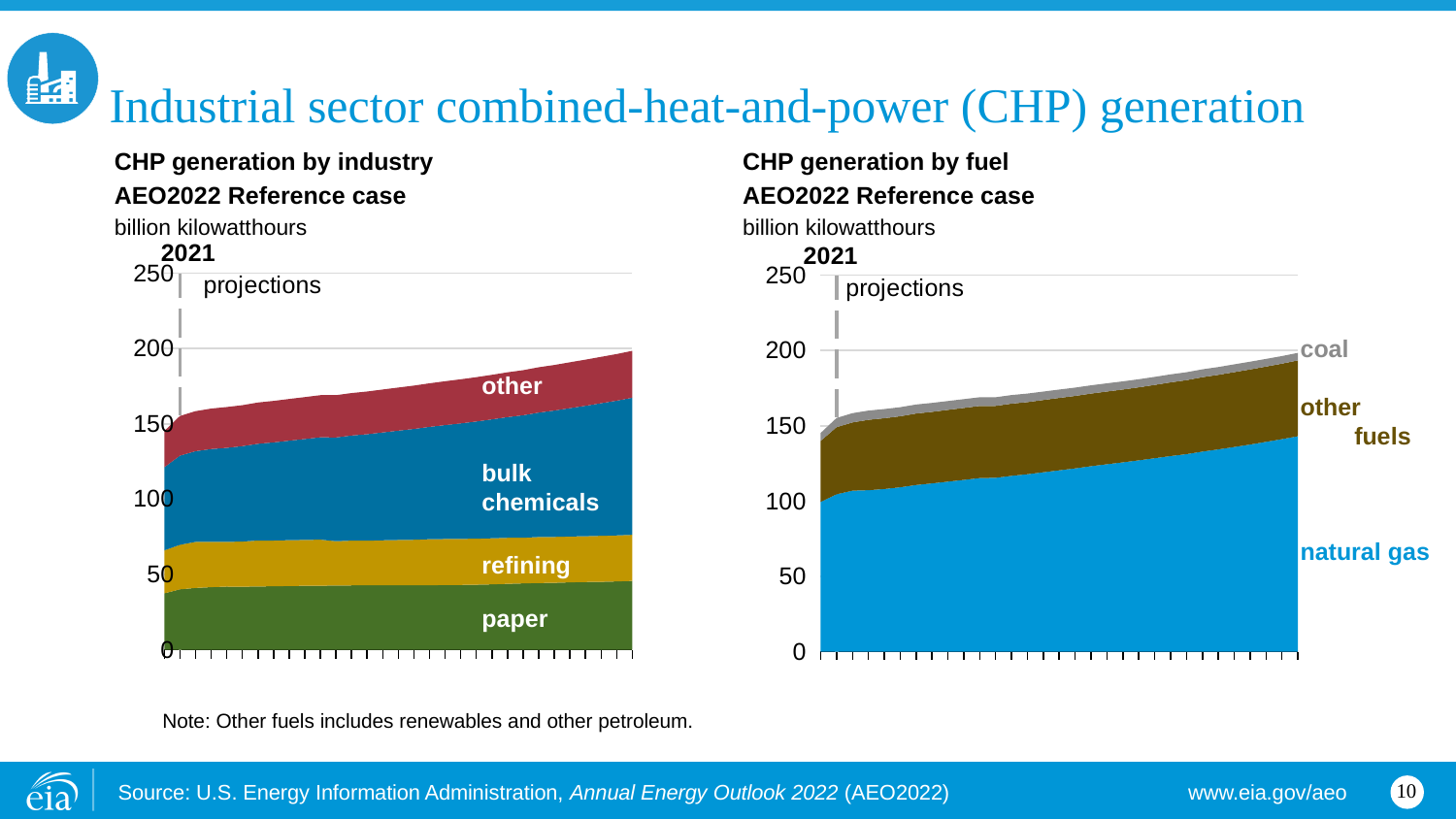
In the 'CHP generation by fuel' chart, which fuel accounts for the smallest share of CHP generation? coal In the 'CHP generation by industry' chart, which series is larger, paper or refining? paper In the 'CHP generation by industry' chart, which industry accounts for the largest share of CHP generation? bulk chemicals In the 'CHP generation by industry' chart, is the value for paper at the end of the projection greater or less than 50? less What unit is used on the y axis of both charts? billion kilowatthours What kind of chart is the 'CHP generation by industry' chart? stacked area chart How many series are labeled in the 'CHP generation by fuel' chart? 3 In the 'CHP generation by industry' chart, does total CHP generation rise or fall over the projection period? rise In the 'CHP generation by fuel' chart, does total CHP generation rise or fall over the projection period? rise In the 'CHP generation by fuel' chart, which fuel accounts for the largest share of CHP generation? natural gas How many industry series are labeled in the 'CHP generation by industry' chart? 4 In the 'CHP generation by fuel' chart, is the value for natural gas at the end of the projection greater or less than 150? less